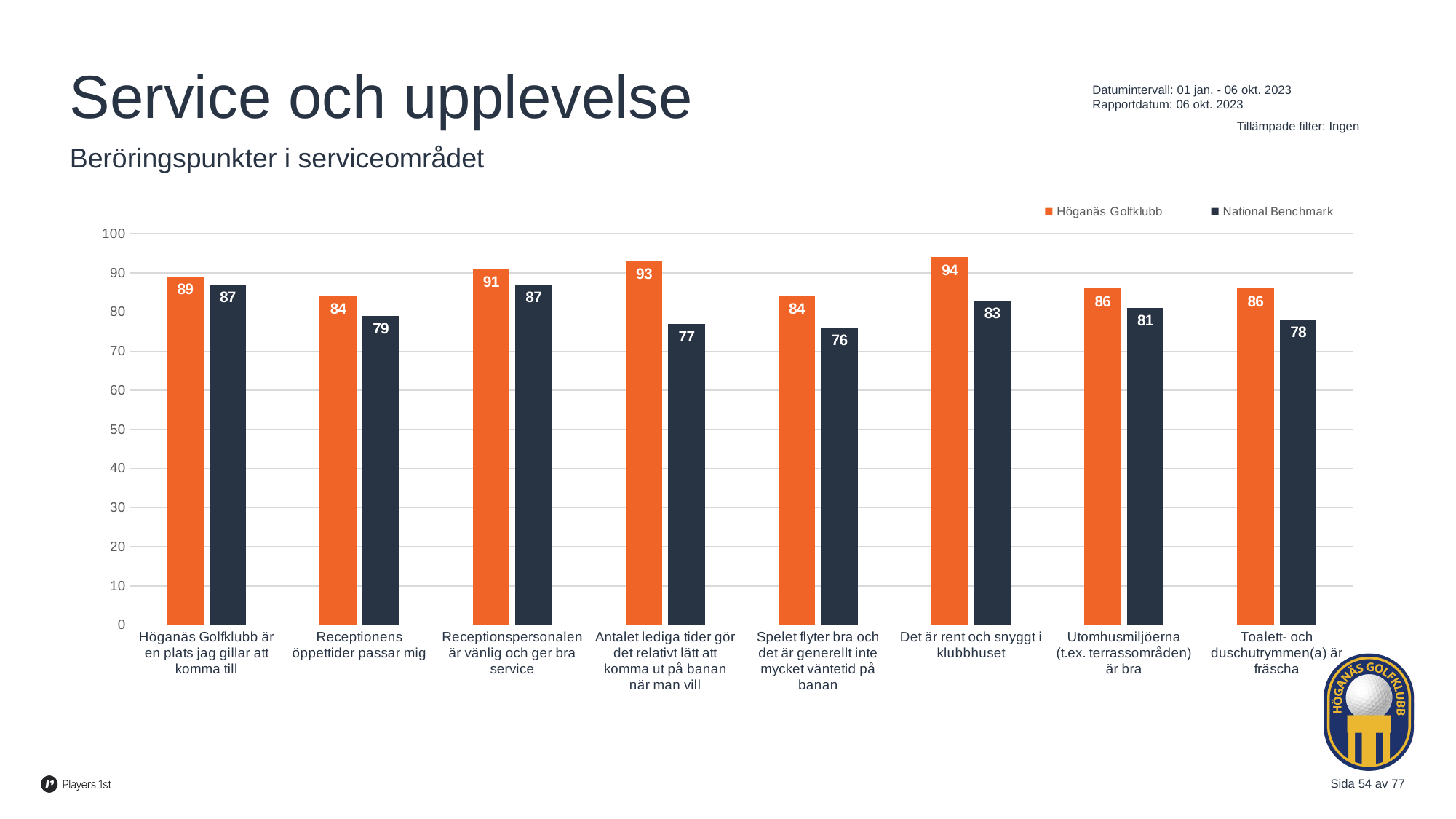
What is the Höganäs Golfklubb value for "Det är rent och snyggt i klubbhuset"? 94 What is the difference between the Höganäs Golfklubb and National Benchmark values for "Antalet lediga tider gör det relativt lätt att komma ut på banan när man vill"? 16 Which category has the highest Höganäs Golfklubb value? Det är rent och snyggt i klubbhuset Which series is shown in orange? Höganäs Golfklubb What is the National Benchmark value for "Spelet flyter bra och det är generellt inte mycket väntetid på banan"? 76 What kind of chart is shown on the slide? Bar chart Which is larger for "Toalett- och duschutrymmen(a) är fräscha": the Höganäs Golfklubb value or the National Benchmark value? Höganäs Golfklubb Which category has the lowest National Benchmark value? Spelet flyter bra och det är generellt inte mycket väntetid på banan What is the National Benchmark value for "Receptionens öppettider passar mig"? 79 Is the National Benchmark value for "Utomhusmiljöerna (t.ex. terrassområden) är bra" greater or less than 90? less How many categories are shown on the x axis? 8 How many series does the legend list? 2